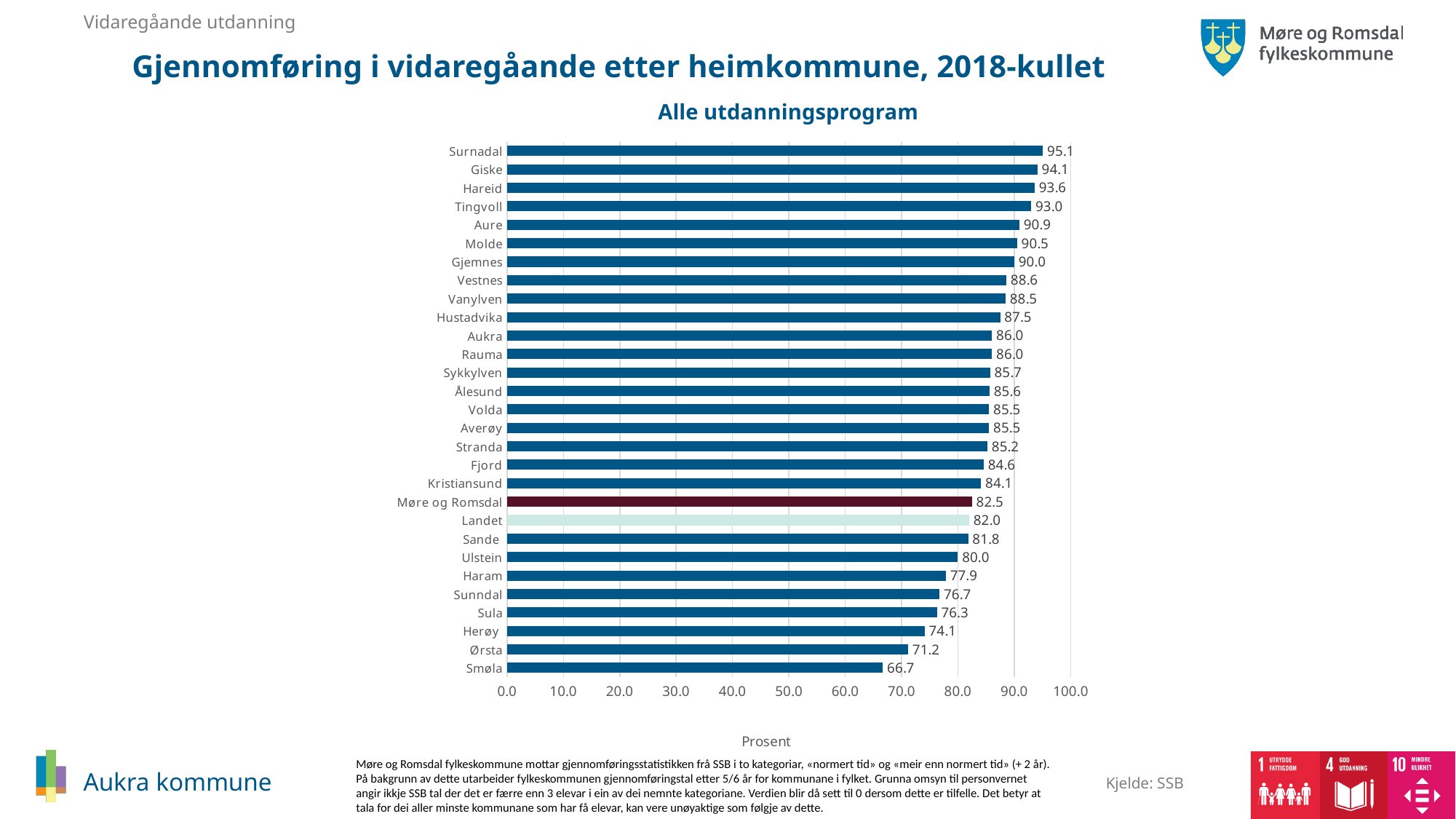
Which category has the lowest value? Smøla Is the value for Ørsta greater or less than 80.0? less What is the value for Aukra? 86.0 What is the title of the chart? Alle utdanningsprogram Which is larger, the value for Molde or the value for Kristiansund? Molde Which category has the highest value? Surnadal What is the value for Møre og Romsdal? 82.5 What kind of chart is shown on the slide? bar chart What is the difference between the values for Surnadal and Smøla? 28.4 How many categories are shown in the chart? 29 What is the value for Landet? 82.0 What is the difference between the values for Aukra and Møre og Romsdal? 3.5